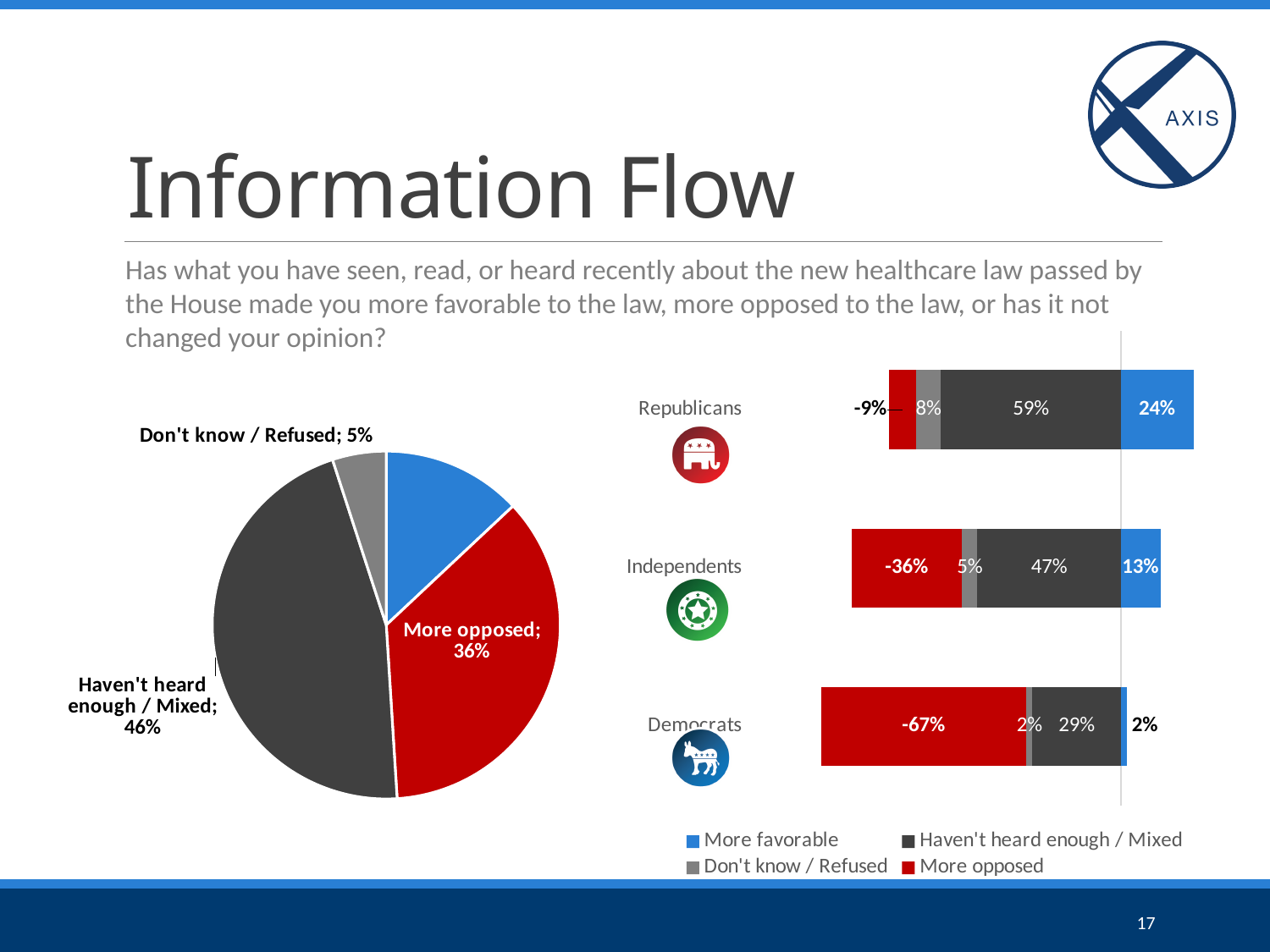
In the pie chart on the left, what share of respondents said "Haven't heard enough / Mixed"? 46% In the bar chart on the right, which group has the lowest "Haven't heard enough / Mixed" value? Democrats In the pie chart on the left, what share of respondents said "More opposed"? 36% In the pie chart on the left, which labeled slice is the largest? Haven't heard enough / Mixed In the bar chart on the right, how many series does the legend list? 4 What kind of chart is shown on the right side of the slide? Bar chart In the bar chart on the right, which group has the highest "More favorable" value? Republicans In the pie chart on the left, what share of respondents said "Don't know / Refused"? 5% In the bar chart on the right, how many groups are shown? 3 In the bar chart on the right, what is the "Haven't heard enough / Mixed" value for Independents? 47% In the bar chart on the right, what is the "More favorable" value for Republicans? 24% In the bar chart on the right, what is the "More opposed" value for Democrats? -67%